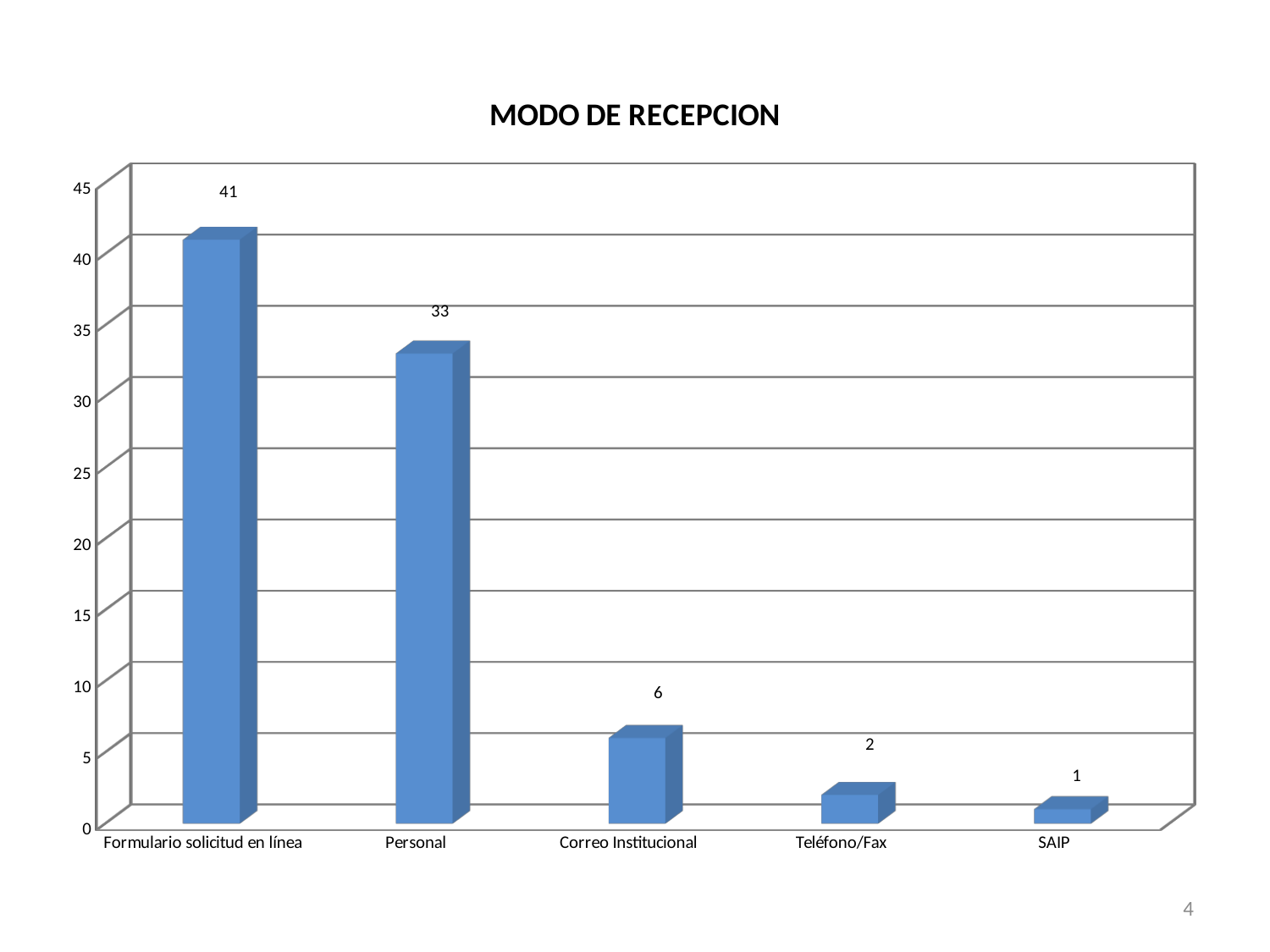
What is the title of the chart? MODO DE RECEPCION What kind of chart is shown on the slide? bar chart Which is larger, the value for Correo Institucional or the value for Teléfono/Fax? Correo Institucional What is the value for Teléfono/Fax? 2 What is the value for Correo Institucional? 6 What is the value for Personal? 33 Which category has the highest value? Formulario solicitud en línea What is the value for Formulario solicitud en línea? 41 Which category has the lowest value? SAIP How many categories are shown on the x axis? 5 What is the difference between the values for Formulario solicitud en línea and Personal? 8 Is the value for Personal greater or less than 30? greater